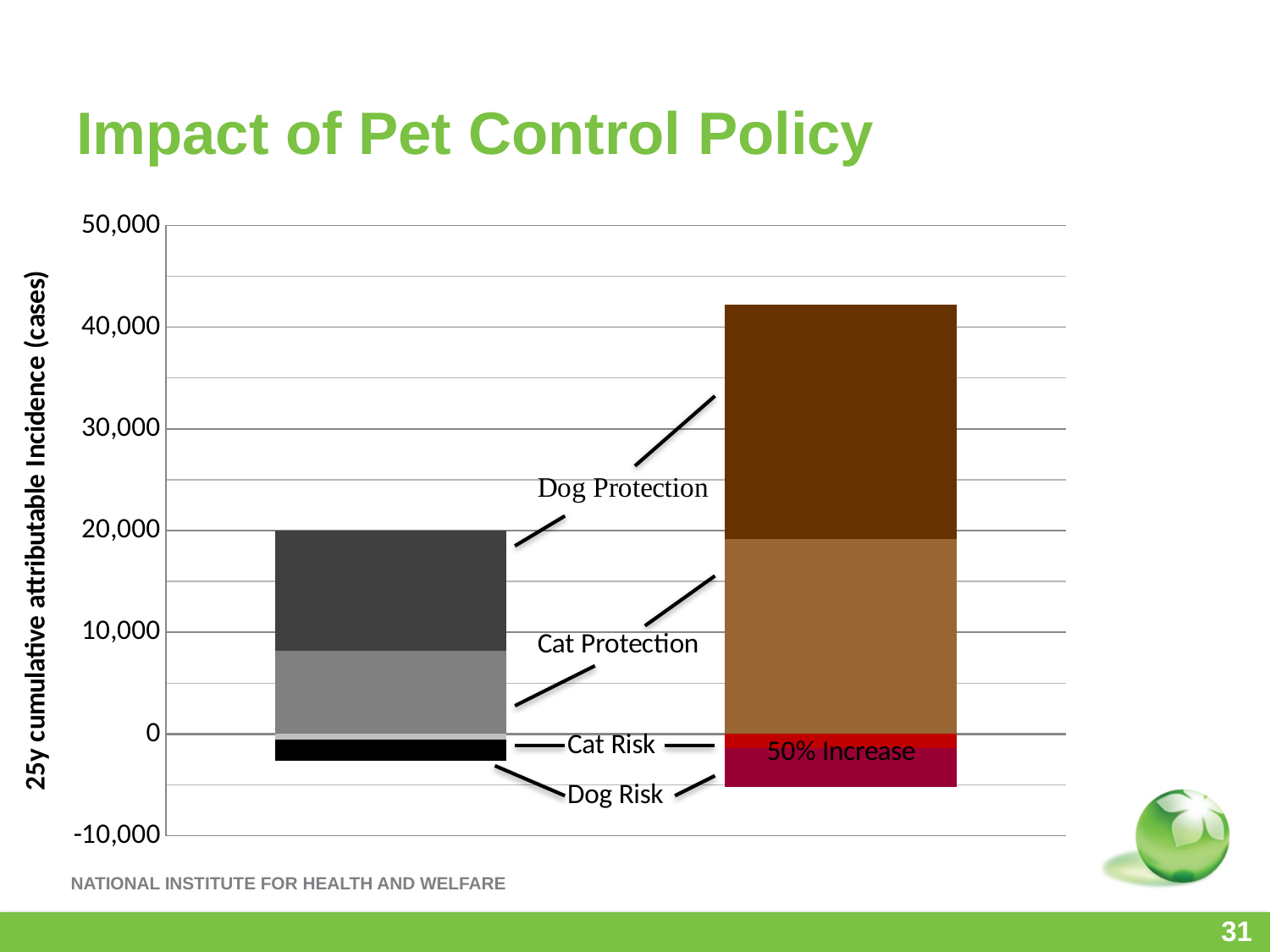
What is the label of the vertical axis? 25y cumulative attributable Incidence (cases) Is the Cat Protection segment of the right (50% Increase) bar greater or less than 10,000? greater Which segment of the right (50% Increase) bar is the largest? Dog Protection Which bar reaches a higher positive total, the left (grey) bar or the right (50% Increase) bar? the right (50% Increase) bar What is the title of the chart on the slide? Impact of Pet Control Policy Which bar has the larger Dog Risk segment (extending further below zero), the left (grey) bar or the right (50% Increase) bar? the right (50% Increase) bar What is the total positive height of the left (grey) stacked bar? 20,000 What kind of chart is shown on the slide? stacked bar chart Is the Cat Protection segment of the left (grey) bar greater or less than 10,000? less Is the bottom of the Dog Risk segment in the right (50% Increase) bar above or below -10,000? above How many stacked bars are plotted in the chart? 2